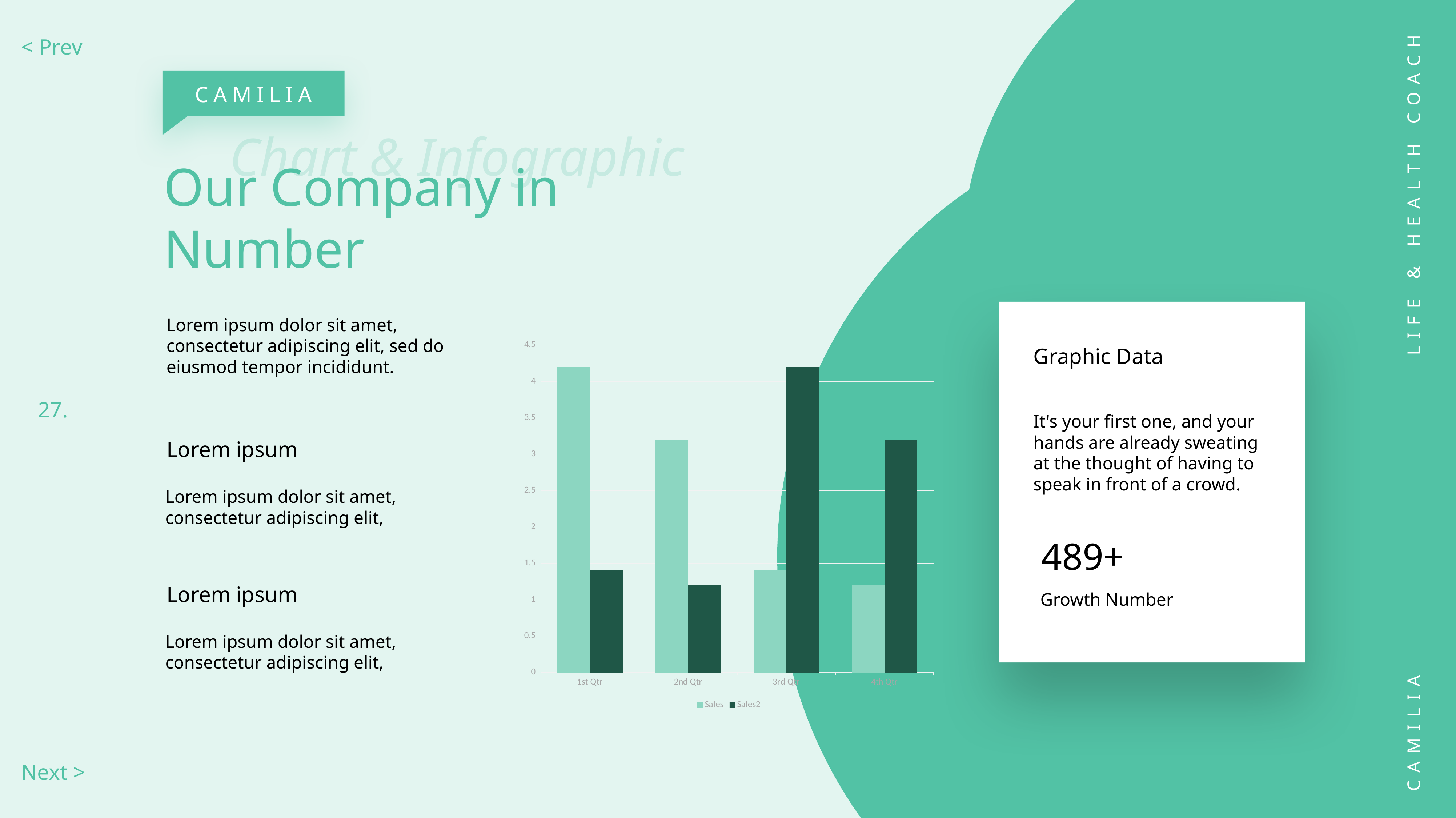
Which quarter has the highest value for the Sales2 series? 3rd Qtr How many series does the chart legend list? 2 Is the value for Sales in 1st Qtr greater or less than 4? greater What are the two series names listed in the chart legend? Sales and Sales2 In 3rd Qtr, which series has the larger value, Sales or Sales2? Sales2 What kind of chart is shown on the slide? bar chart Is the value for Sales2 in 4th Qtr greater or less than 3? greater Is the value for Sales in 4th Qtr greater or less than 1.5? less How many categories are shown on the x axis of the chart? 4 Which quarter has the highest value for the Sales series? 1st Qtr Do the values for the Sales series rise or fall from 1st Qtr to 4th Qtr? fall In 1st Qtr, which series has the larger value, Sales or Sales2? Sales